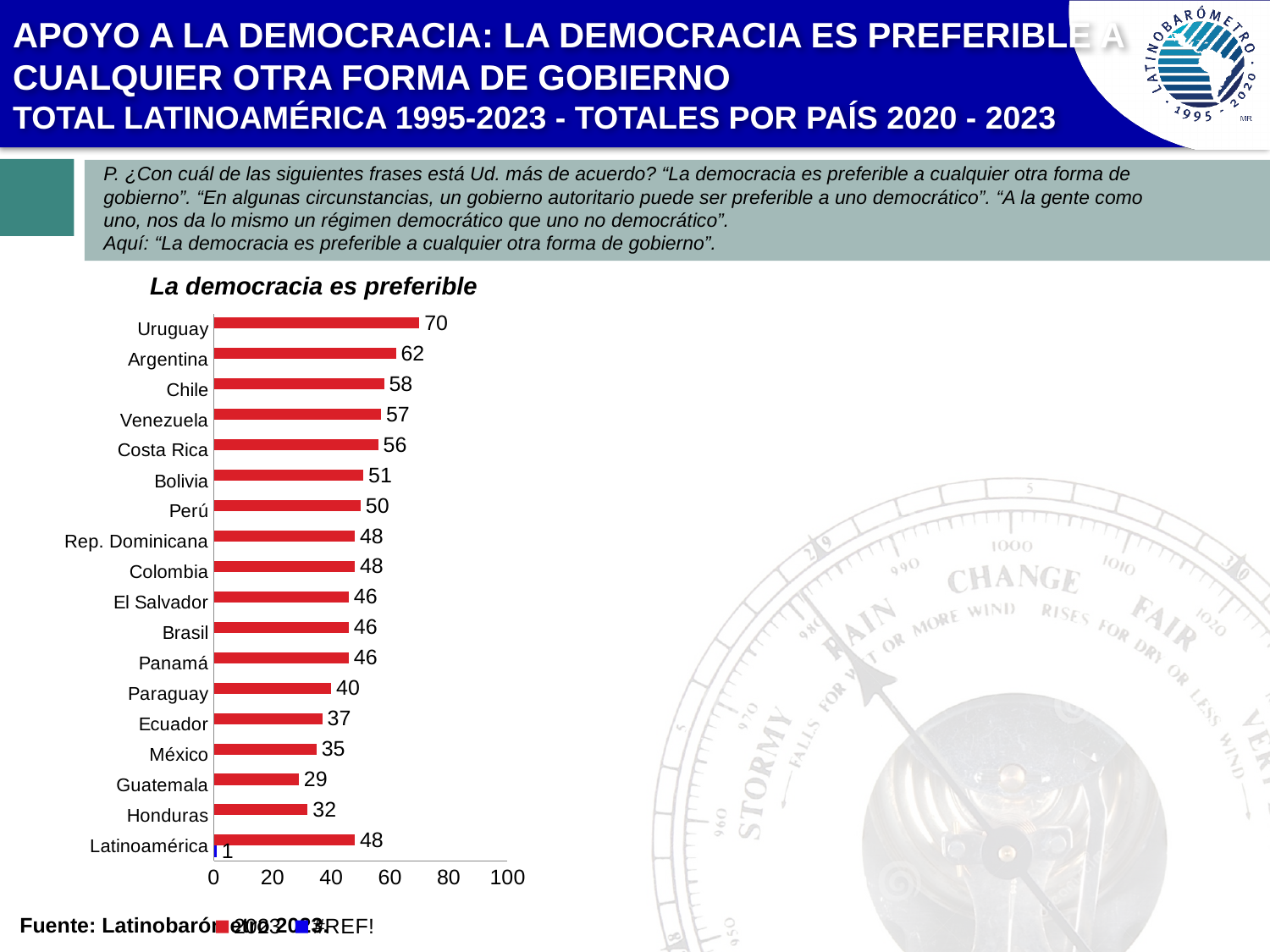
What is the title of the chart? La democracia es preferible What is the value for Argentina in the chart? 62 What is the value for Latinoamérica in the red series? 48 What is the difference between the values for Uruguay and Argentina? 8 Which has a larger value, Paraguay or Ecuador? Paraguay What is the value for Honduras in the chart? 32 Is the value for Costa Rica greater or less than 40? greater Which country has the lowest value in the chart? Guatemala What is the difference between the values for Chile and México? 23 What is the value for Uruguay in the chart? 70 Which country has the highest value in the chart? Uruguay What type of chart is shown on the slide? bar chart